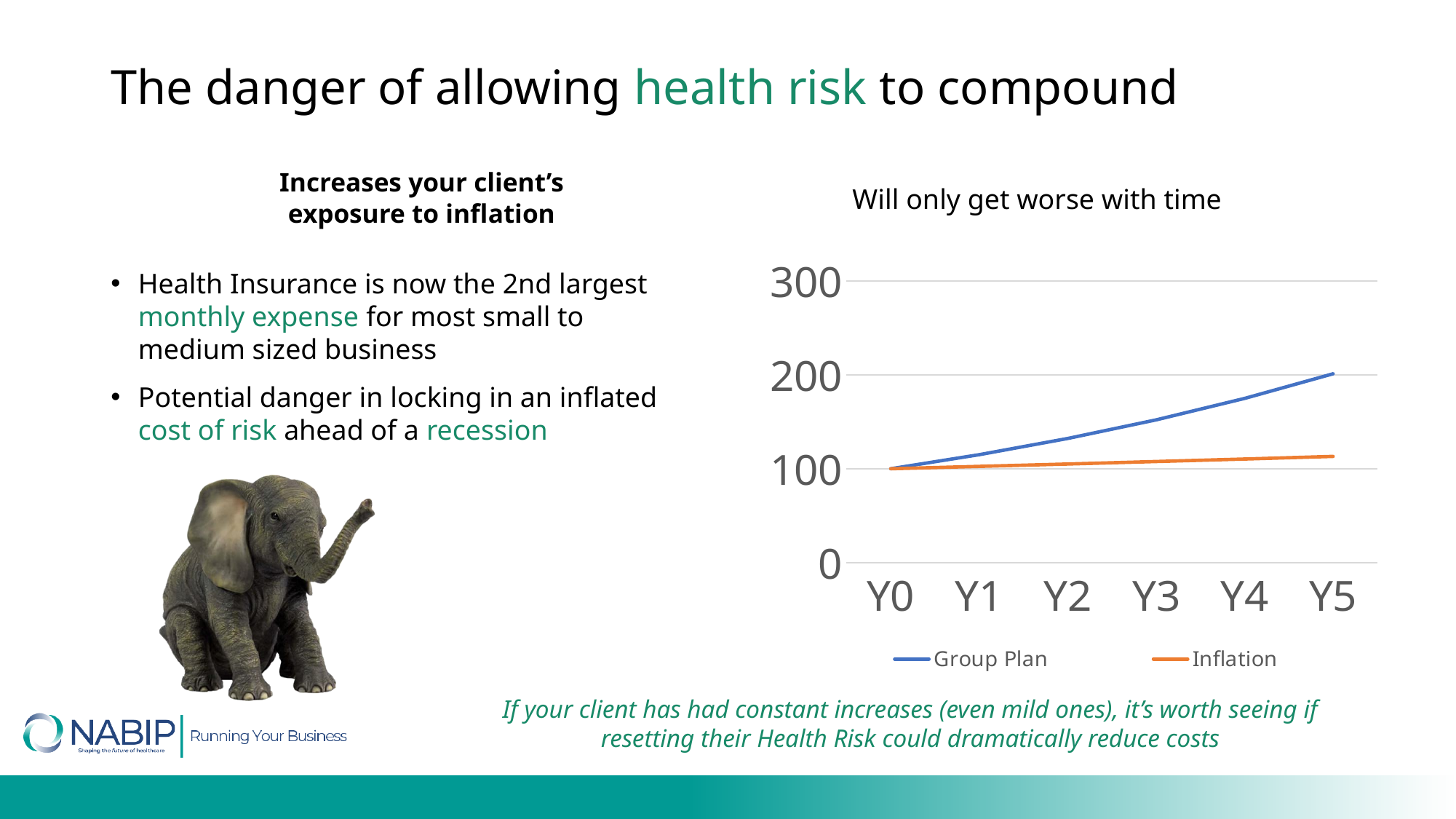
Is the value for Inflation at Y5 greater or less than 200? less What kind of chart is shown on the slide? line chart What is the title of the chart? Will only get worse with time Which colour is the Group Plan line in the chart? blue Which series has the lowest value at Y5? Inflation How many points are plotted along the x axis of the chart? 6 Is the value for Group Plan at Y5 greater or less than 100? greater Is the value for Group Plan at Y3 greater or less than 200? less Does the Group Plan line rise or fall from Y0 to Y5? rise What is the value for Group Plan at Y0? 100 How many series does the chart legend list? 2 At Y5, which series has the higher value, Group Plan or Inflation? Group Plan